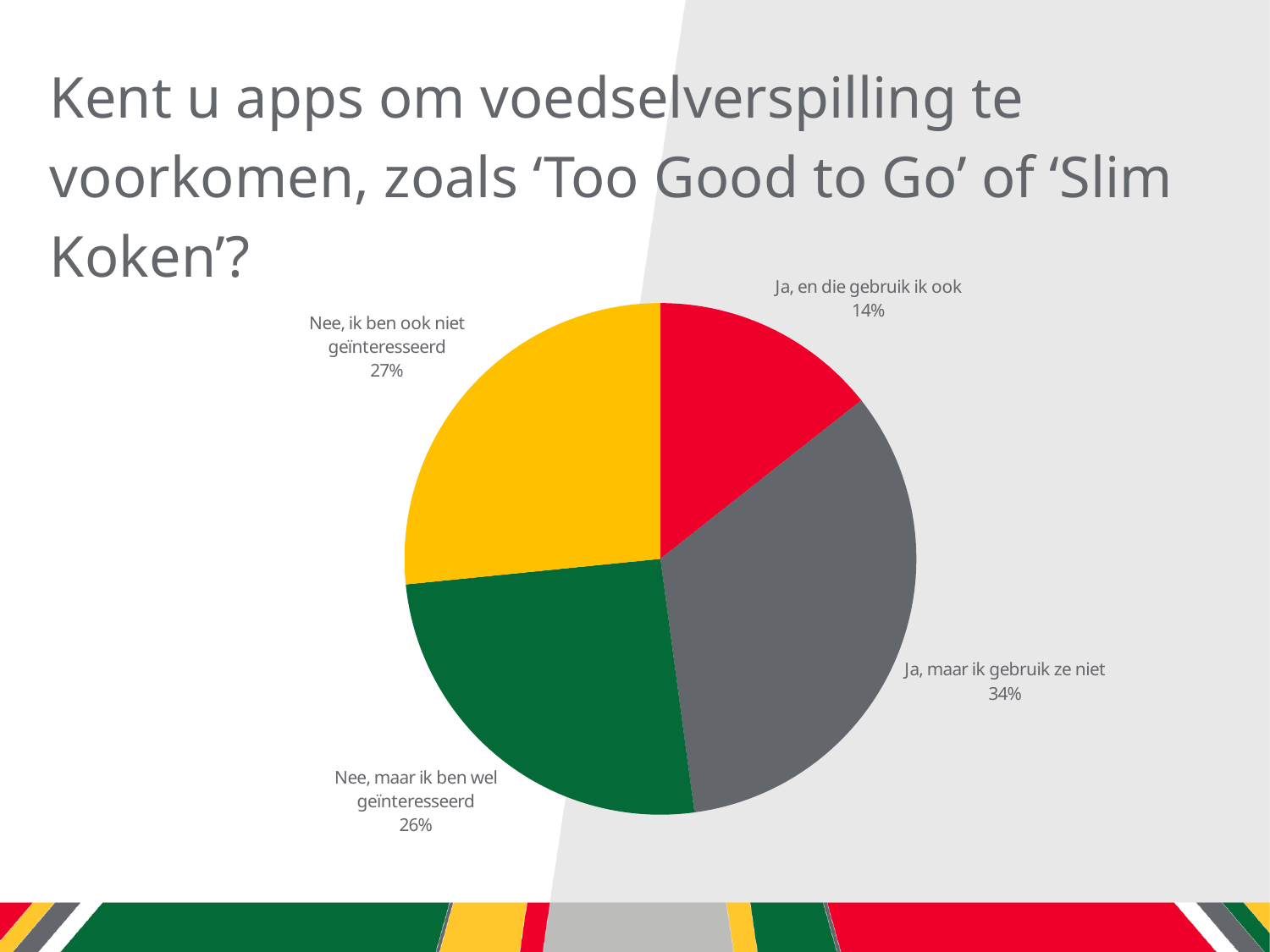
How many slices does the pie chart have? 4 What kind of chart is shown on the slide? pie chart Which answer has the smallest share of the pie? Ja, en die gebruik ik ook What share of respondents answered 'Ja, maar ik gebruik ze niet'? 34% What share of respondents answered 'Ja, en die gebruik ik ook'? 14% What share of respondents answered 'Nee, maar ik ben wel geïnteresseerd'? 26% What is the difference in percentage points between 'Ja, maar ik gebruik ze niet' and 'Ja, en die gebruik ik ook'? 20 percentage points Which is larger: the share for 'Ja, maar ik gebruik ze niet' or the share for 'Nee, ik ben ook niet geïnteresseerd'? Ja, maar ik gebruik ze niet Which answer has the largest share of the pie? Ja, maar ik gebruik ze niet What colour is the slice for 'Ja, en die gebruik ik ook'? red What share of respondents answered 'Nee, ik ben ook niet geïnteresseerd'? 27% What is the combined share of the two 'Nee' answers? 53%